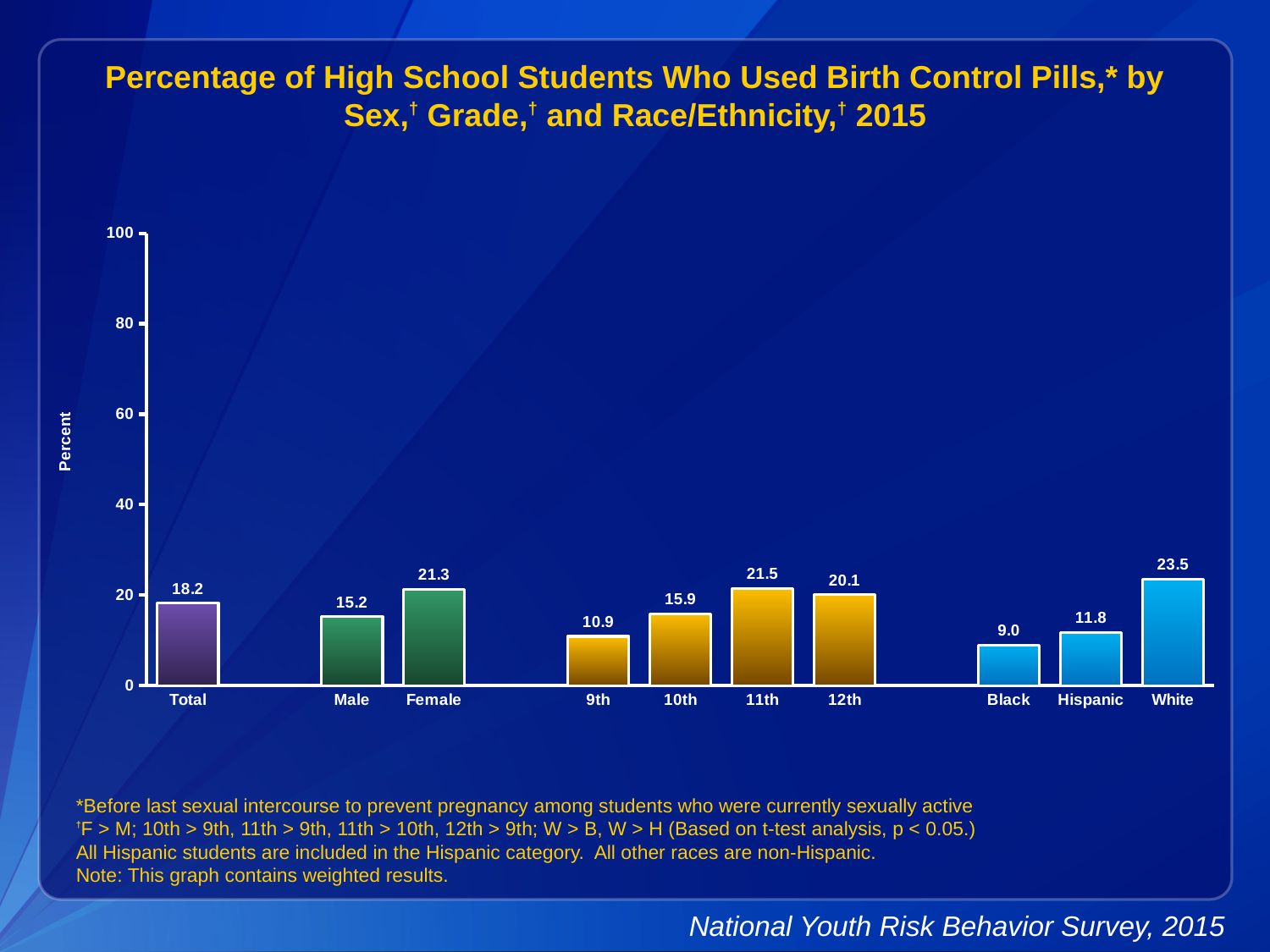
How many bars are shown in the chart? 10 What is the difference between the Female and Male values? 6.1 What is the value for Total? 18.2 Which is larger, the value for 11th grade or 12th grade? 11th What is the value for 9th grade? 10.9 What is the label of the y axis? Percent What kind of chart is shown on the slide? bar chart Which category has the lowest value? Black Is the value for White greater or less than 20? greater What is the value for Hispanic? 11.8 What is the value for Female? 21.3 Which category has the highest value? White